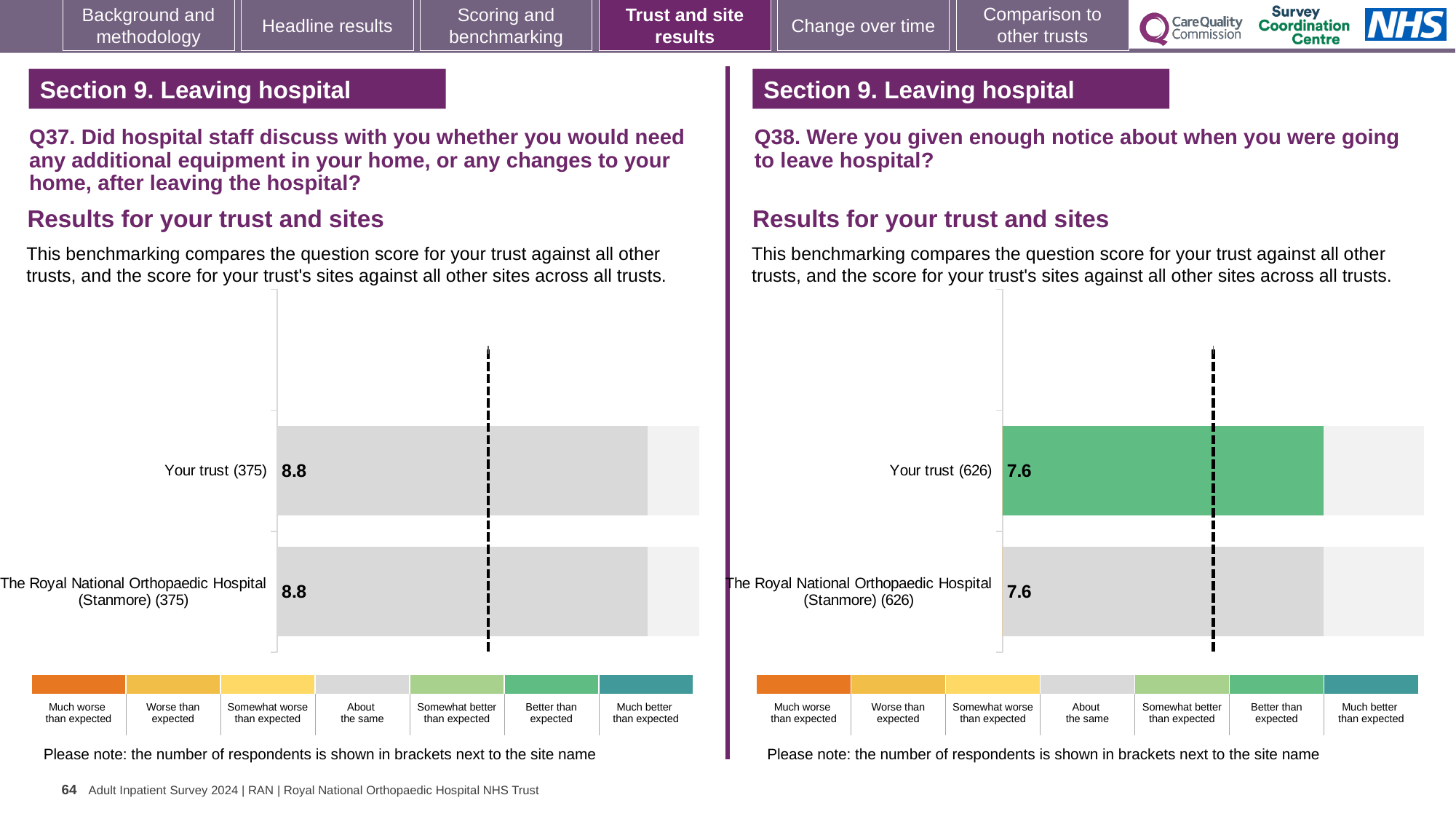
How many bars are plotted on the Q38 chart (right)? 2 How many respondents are shown in brackets for Your trust on the Q38 chart (right)? 626 How many categories does the colour legend below the Q37 chart (left) list? 7 On the Q37 chart (left), what is the score for Your trust (375)? 8.8 On the Q37 chart (left), what is the difference between the score for Your trust and the score for The Royal National Orthopaedic Hospital (Stanmore)? 0.0 How many bars are plotted on the Q37 chart (left)? 2 What kind of chart is used on the Q38 chart (right)? Bar chart On the Q37 chart (left), what is the score for The Royal National Orthopaedic Hospital (Stanmore) (375)? 8.8 On the Q38 chart (right), what is the difference between the score for Your trust and the score for The Royal National Orthopaedic Hospital (Stanmore)? 0.0 On the Q38 chart (right), which benchmark category does the green colour of the Your trust bar represent according to the legend? Better than expected On the Q38 chart (right), what is the score for The Royal National Orthopaedic Hospital (Stanmore) (626)? 7.6 On the Q38 chart (right), what is the score for Your trust (626)? 7.6